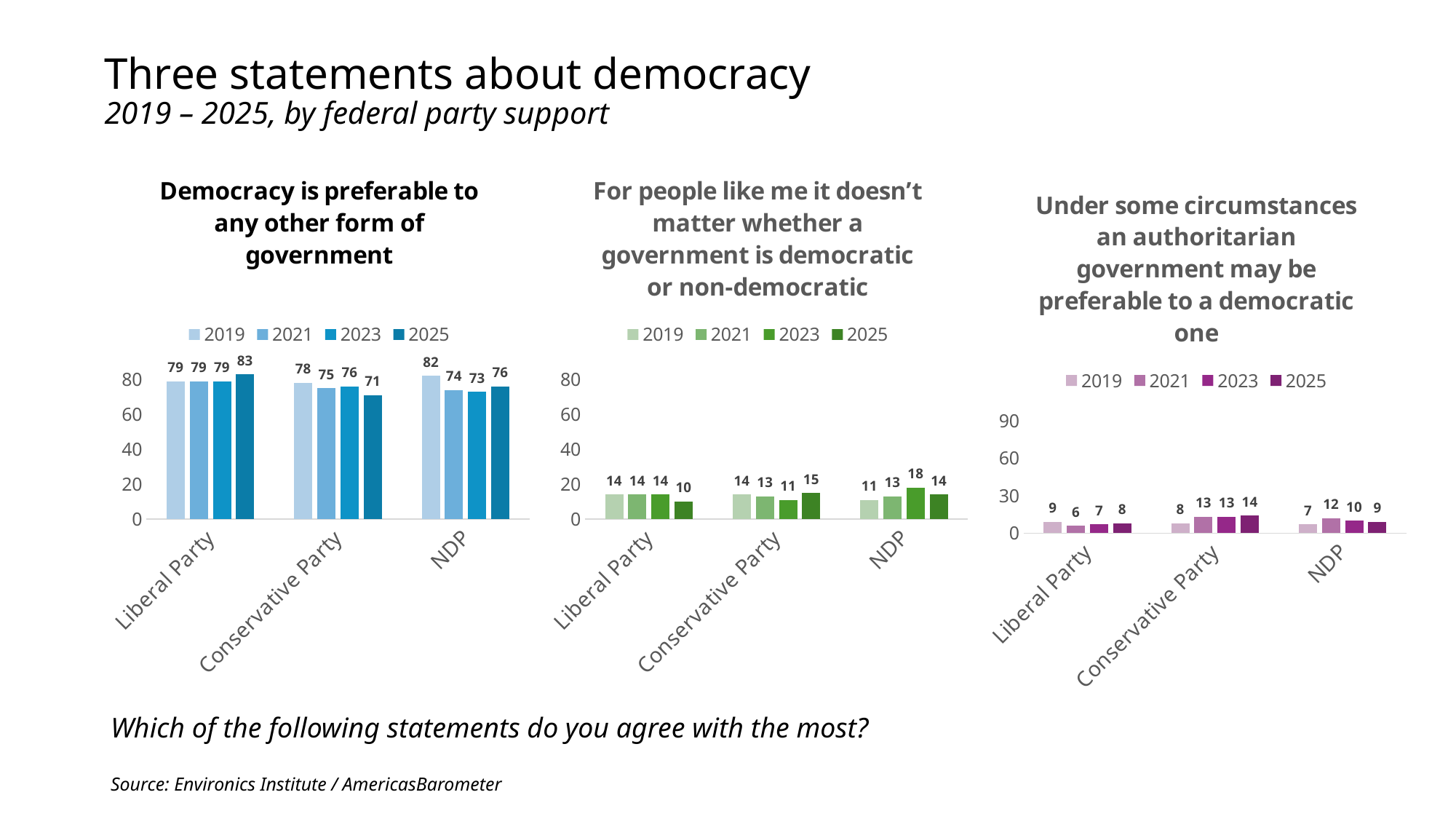
In the chart titled 'For people like me it doesn't matter whether a government is democratic or non-democratic', which party has the highest value in 2025? Conservative Party In the chart titled 'Democracy is preferable to any other form of government', what is the difference between the NDP values for 2019 and 2025? 6 What kind of chart is the chart titled 'For people like me it doesn't matter whether a government is democratic or non-democratic'? Bar chart In the chart titled 'Democracy is preferable to any other form of government', what is the value for the Liberal Party in 2025? 83 In the chart titled 'Democracy is preferable to any other form of government', what is the value for the Conservative Party in 2019? 78 How many party categories are shown on the x axis of the chart titled 'Democracy is preferable to any other form of government'? 3 In the chart titled 'For people like me it doesn't matter whether a government is democratic or non-democratic', is the 2025 value for the Liberal Party greater or less than 20? less In the chart titled 'For people like me it doesn't matter whether a government is democratic or non-democratic', what is the value for the NDP in 2023? 18 In the chart titled 'Democracy is preferable to any other form of government', which party has the lowest value in 2025? Conservative Party In the chart titled 'Under some circumstances an authoritarian government may be preferable to a democratic one', which is larger: the NDP value in 2021 or the Liberal Party value in 2021? NDP value in 2021 In the chart titled 'Under some circumstances an authoritarian government may be preferable to a democratic one', how many series does the legend list? 4 In the chart titled 'Under some circumstances an authoritarian government may be preferable to a democratic one', what is the value for the Conservative Party in 2025? 14